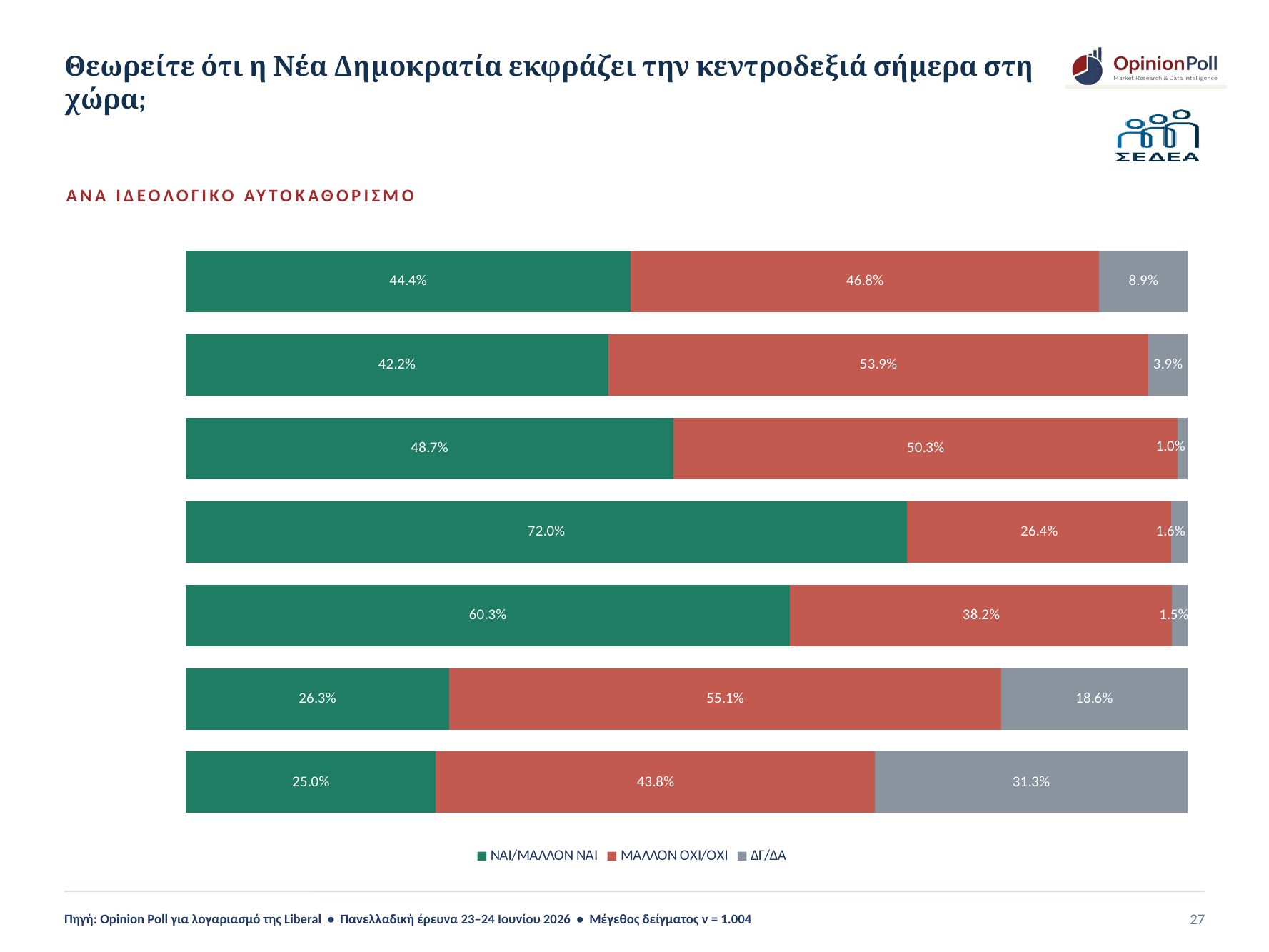
What is the ΔΓ/ΔΑ value for the bottom bar? 31.3% Which colour represents the ΜΑΛΛΟΝ ΟΧΙ/ΟΧΙ series? Red Which is larger: the ΔΓ/ΔΑ value of the bottom bar or the ΔΓ/ΔΑ value of the second bar from the bottom? The bottom bar (31.3%) What kind of chart is shown on the slide? Stacked bar chart How many bars are plotted in the chart? 7 What is the difference between the ΔΓ/ΔΑ values of the bottom bar and the second bar from the bottom? 12.7 percentage points Which bar has the lowest ΔΓ/ΔΑ value? The third bar from the top (1.0%) What is the ΜΑΛΛΟΝ ΟΧΙ/ΟΧΙ value for the second bar from the top? 53.9% Which bar has the highest ΝΑΙ/ΜΑΛΛΟΝ ΝΑΙ value? The fourth bar from the top (72.0%) How many series does the legend list? 3 What is the ΝΑΙ/ΜΑΛΛΟΝ ΝΑΙ value for the top bar? 44.4% In the fourth bar from the top, what is the difference between the ΝΑΙ/ΜΑΛΛΟΝ ΝΑΙ and ΜΑΛΛΟΝ ΟΧΙ/ΟΧΙ values? 45.6 percentage points